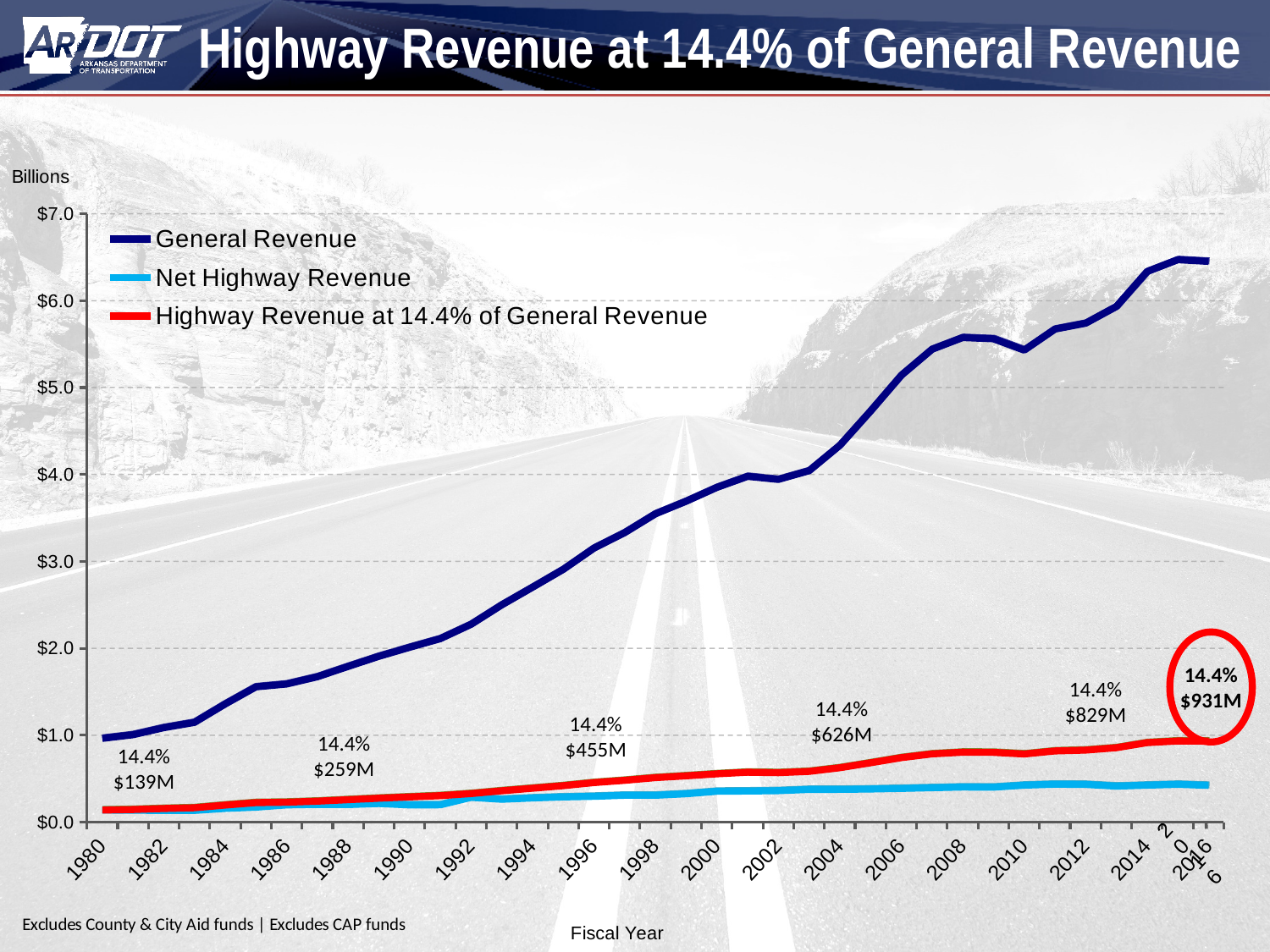
What is the title of the x axis? Fiscal Year What is the labelled value of Highway Revenue at 14.4% of General Revenue shown near 2004? $626M What is the labelled value of Highway Revenue at 14.4% of General Revenue for 2016 (the circled label)? $931M What is the difference between the 2016 label ($931M) and the 1980 label ($139M) for Highway Revenue at 14.4% of General Revenue? $792M What kind of chart is shown on the slide? line chart Which series is higher in 2016, General Revenue or Net Highway Revenue? General Revenue What is the labelled value of Highway Revenue at 14.4% of General Revenue for 1980? $139M How many series does the legend list? 3 Is the General Revenue value for 2016 greater or less than $6.0 billion? greater What is the labelled value of Highway Revenue at 14.4% of General Revenue shown near 2012? $829M Does General Revenue generally rise or fall from 1980 to 2016? rise Is the General Revenue value for 1980 greater or less than $2.0 billion? less